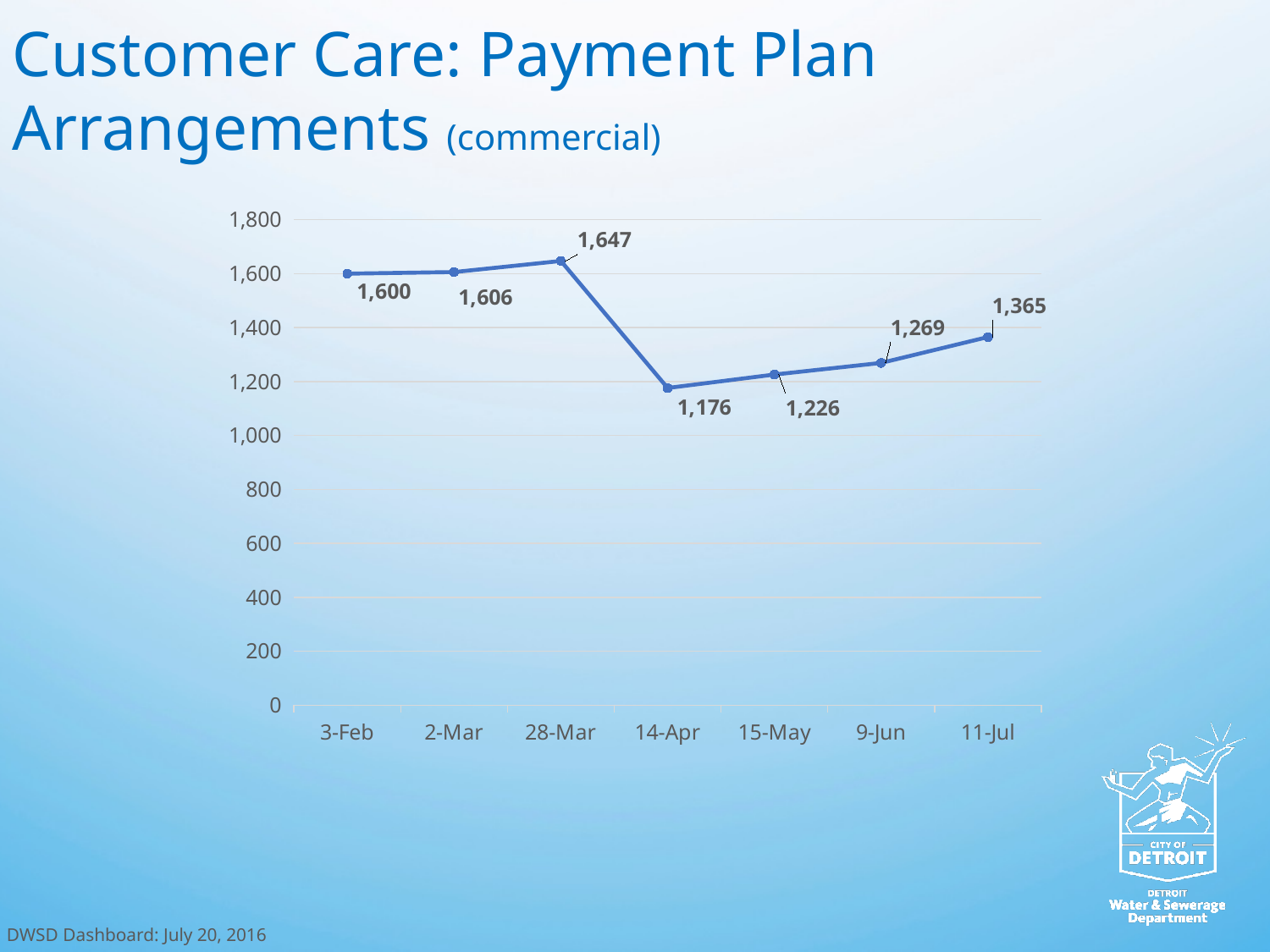
What kind of chart is shown on the slide? line chart What is the difference between the values for 28-Mar and 14-Apr? 471 What is the difference between the values for 11-Jul and 9-Jun? 96 Which date has the highest value? 28-Mar How many dates are plotted on the chart? 7 Which date has the lowest value? 14-Apr Is the value for 9-Jun greater or less than 1,200? greater Do the values rise or fall from 14-Apr to 11-Jul? rise Which is larger, the value for 2-Mar or the value for 15-May? 2-Mar What is the value for 3-Feb? 1,600 What is the value for 14-Apr? 1,176 What is the value for 11-Jul? 1,365